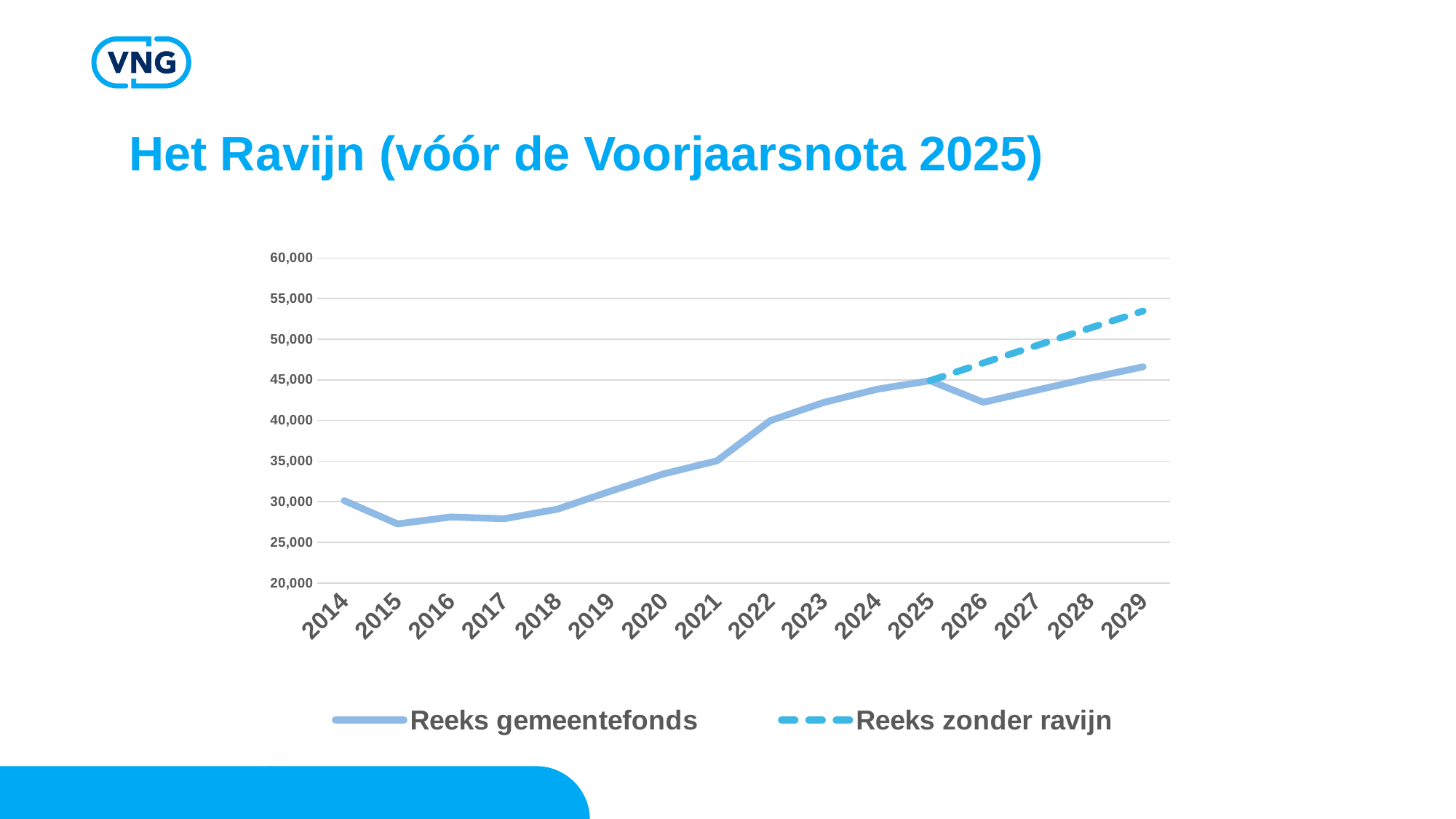
What is the title of the slide containing the chart? Het Ravijn (vóór de Voorjaarsnota 2025) Which series is drawn with a dashed line? Reeks zonder ravijn What kind of chart is shown on the slide? line chart Does the Reeks gemeentefonds line rise or fall from 2025 to 2026? fall In which year is the Reeks gemeentefonds value lowest? 2015 In 2029, which series has the higher value, Reeks gemeentefonds or Reeks zonder ravijn? Reeks zonder ravijn How many series does the legend list? 2 How many years are shown on the x axis? 16 Is the Reeks gemeentefonds value for 2015 greater or less than 30,000? less In which year is the Reeks gemeentefonds value highest? 2029 Is the Reeks gemeentefonds value for 2026 greater or less than 45,000? less Is the Reeks zonder ravijn value for 2029 greater or less than 50,000? greater